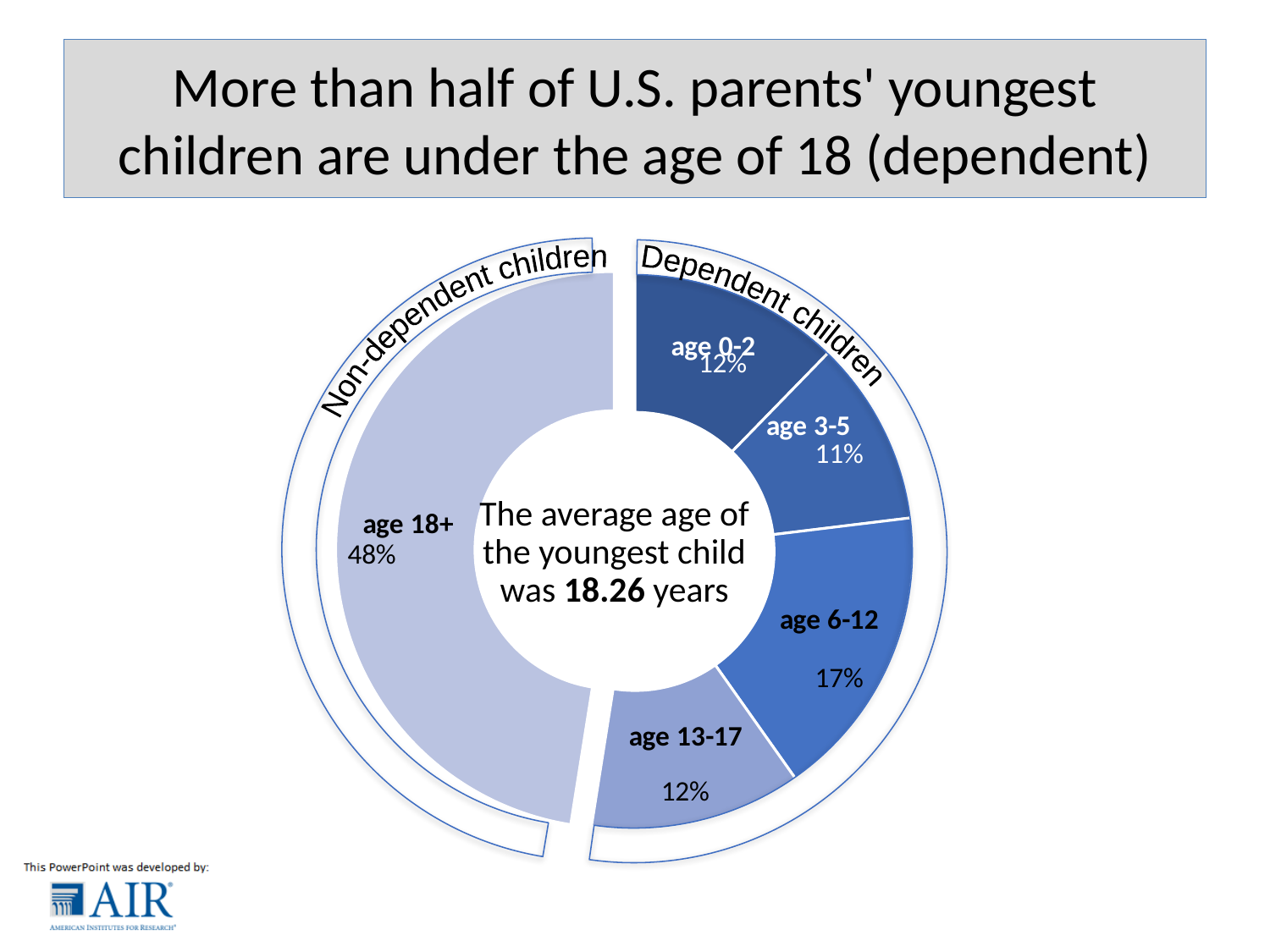
Which age group has the smallest slice of the chart? age 3-5 What percentage is shown for the age 13-17 slice? 12% What percentage is shown for the age 6-12 slice? 17% What share of the chart does the age 18+ slice represent? 48% How many age-group slices does the chart have? 5 How many percentage points larger is the age 18+ slice than the age 6-12 slice? 31 percentage points What percentage is shown for the age 3-5 slice? 11% What kind of chart is shown on the slide? doughnut chart Which slice is larger, age 6-12 or age 13-17? age 6-12 Which age group has the largest slice of the chart? age 18+ According to the text in the centre of the chart, what was the average age of the youngest child? 18.26 years What is the combined share of the four dependent-children slices (age 0-2, 3-5, 6-12 and 13-17)? 52%